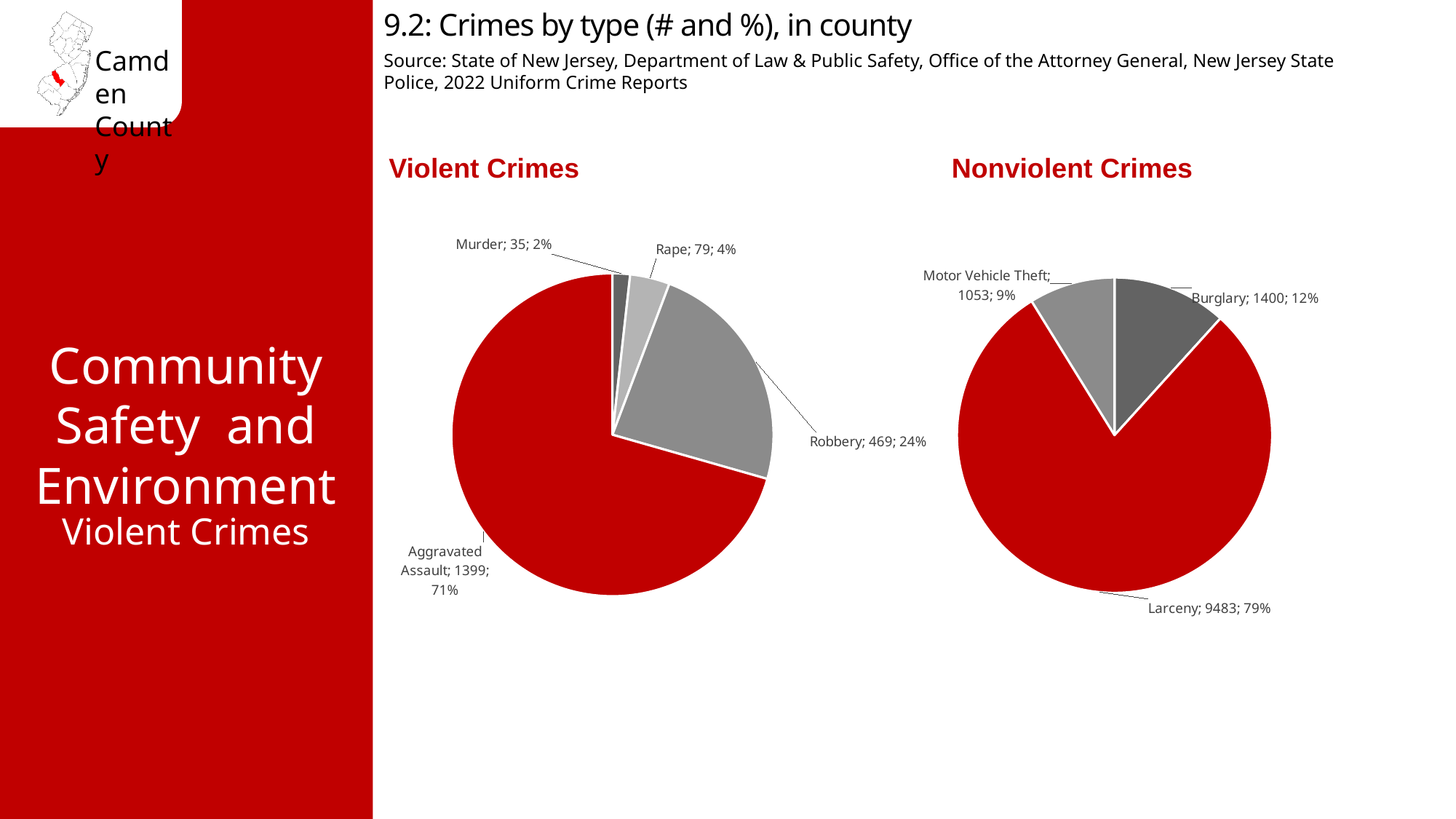
In the Violent Crimes chart, how many aggravated assaults are shown? 1399 In the Violent Crimes chart, how many categories are shown? 4 In the Violent Crimes chart, which category has the largest slice? Aggravated Assault What type of chart is the Nonviolent Crimes chart? Pie chart In the Violent Crimes chart, what is the difference between the number of robberies and the number of rapes? 390 What is the title of the slide's chart section? 9.2: Crimes by type (# and %), in county In the Nonviolent Crimes chart, how many larcenies are shown? 9483 In the Violent Crimes chart, which category has the smallest slice? Murder In the Nonviolent Crimes chart, what share of the pie is Motor Vehicle Theft? 9% In the Nonviolent Crimes chart, what is the difference between the number of burglaries and motor vehicle thefts? 347 In the Violent Crimes chart, what share of the pie is Robbery? 24% In the Nonviolent Crimes chart, which is larger, Burglary or Motor Vehicle Theft? Burglary